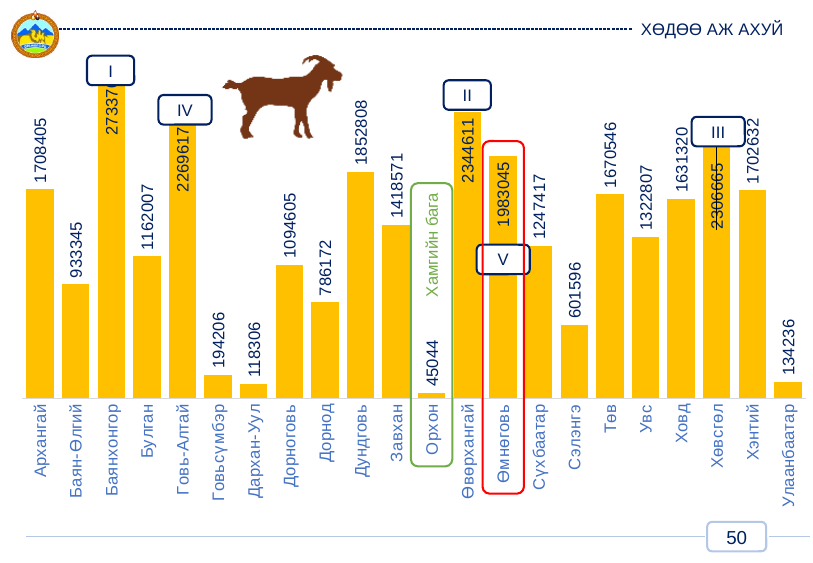
Which category has the tallest bar? Баянхонгор What is the value shown for Орхон? 45044 What kind of chart is shown on the slide? Bar chart Which has a larger value, Төв or Ховд? Төв What is the difference between the values for Говь-Алтай and Дундговь? 416809 What is the difference between the values for Сүхбаатар and Сэлэнгэ? 645821 What is the value shown for Өмнөговь? 1983045 What is the value shown for Улаанбаатар? 134236 What is the value shown for Архангай? 1708405 What is the value shown for Өвөрхангай? 2344611 Which category has the lowest value? Орхон How many categories are shown on the x axis? 22